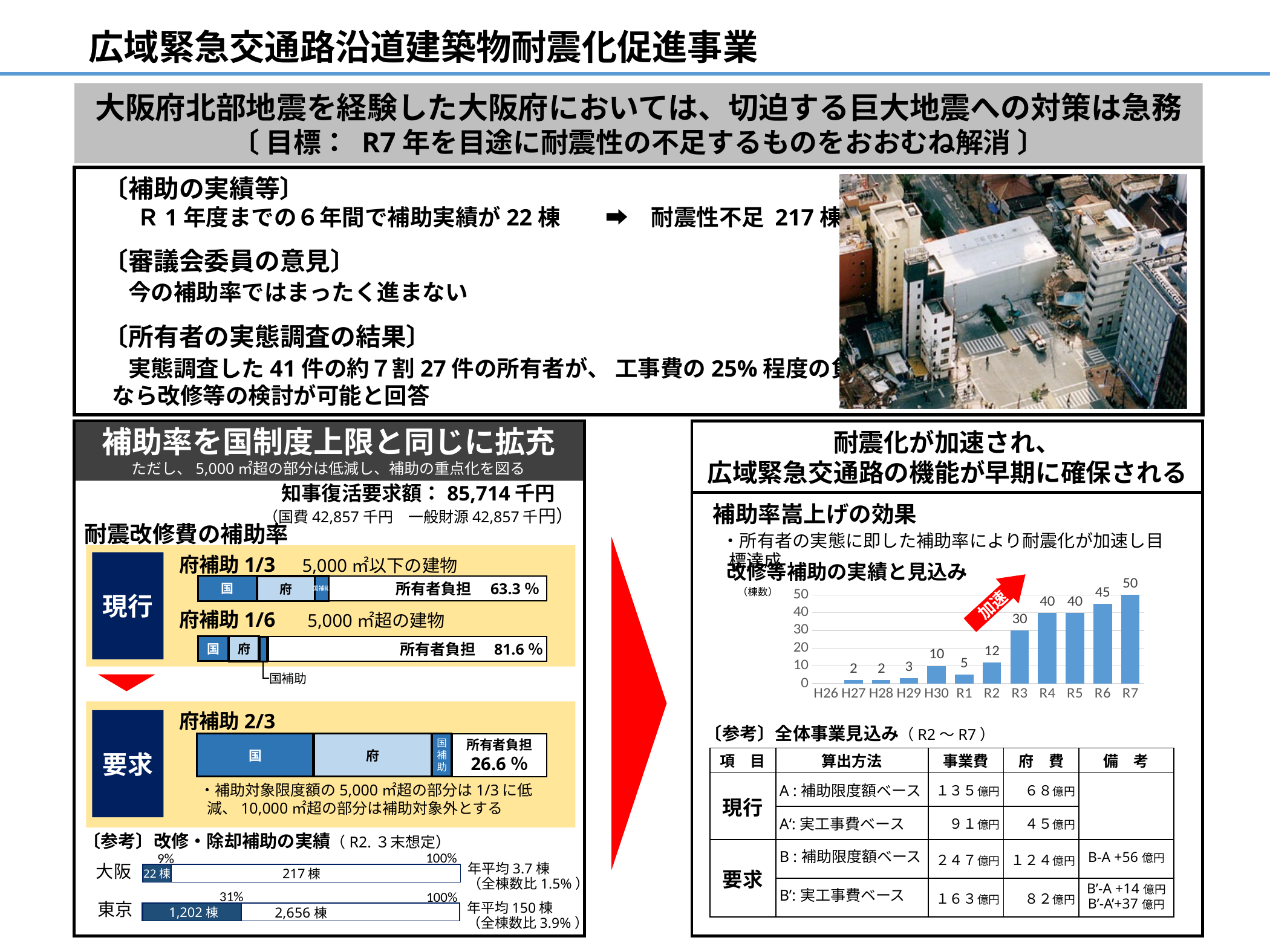
In the bar chart 改修等補助の実績と見込み, what is the value for H30? 10 In the bar chart 改修等補助の実績と見込み, what is the difference between the values for R6 and R3? 15 In the bar chart 改修等補助の実績と見込み, what is the value for R7? 50 What unit label is shown next to the y axis of the bar chart 改修等補助の実績と見込み? (棟数) In the bar chart 改修等補助の実績と見込み, do the values generally rise or fall from H27 to R7? rise In the bar chart 改修等補助の実績と見込み, which year has the highest value? R7 In the bar chart 改修等補助の実績と見込み, what is the value for R1? 5 In the bar chart 改修等補助の実績と見込み, what is the difference between the values for R7 and R2? 38 How many year categories are shown on the x axis of the bar chart 改修等補助の実績と見込み? 12 In the bar chart 改修等補助の実績と見込み, which is larger, the value for R3 or the value for R1? R3 What kind of chart is 改修等補助の実績と見込み? bar chart In the bar chart 改修等補助の実績と見込み, what is the value for R3? 30